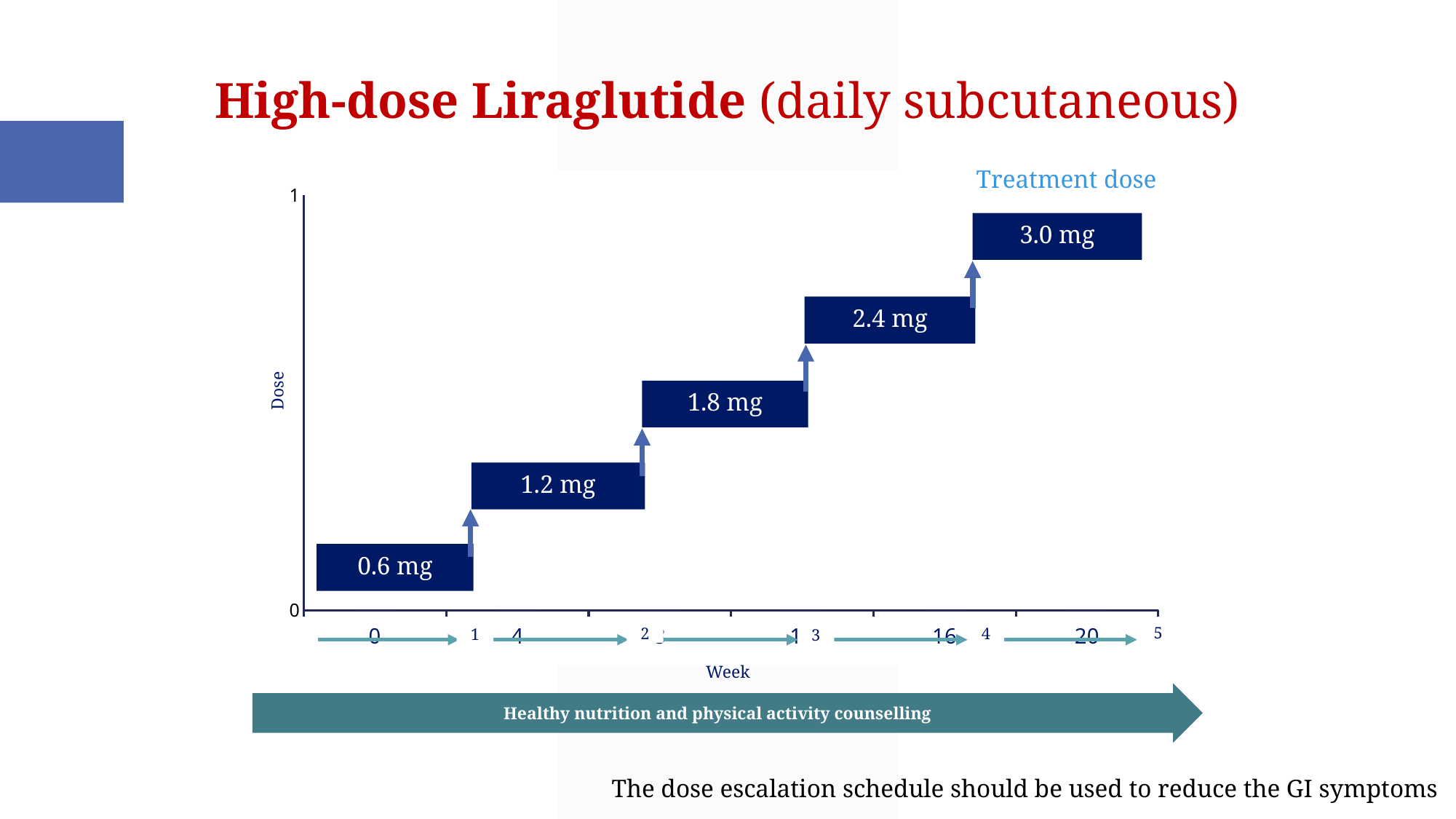
Which is larger, the dose on the second step or the dose on the fourth step? The fourth step (2.4 mg) What is the highest dose shown on the chart? 3.0 mg Do the doses rise or fall as the weeks progress along the x axis? Rise How many dose steps are shown on the chart? 5 Which dose step is labelled as the 'Treatment dose'? 3.0 mg What dose is labelled on the third step of the escalation chart? 1.8 mg What is the label on the vertical axis of the chart? Dose By how much does the dose increase from the 1.2 mg step to the 1.8 mg step? 0.6 mg What is the difference between the highest dose (3.0 mg) and the lowest dose (0.6 mg)? 2.4 mg What dose is labelled on the second step of the escalation chart? 1.2 mg What dose is labelled on the fourth step of the escalation chart? 2.4 mg What is the lowest dose shown on the chart? 0.6 mg